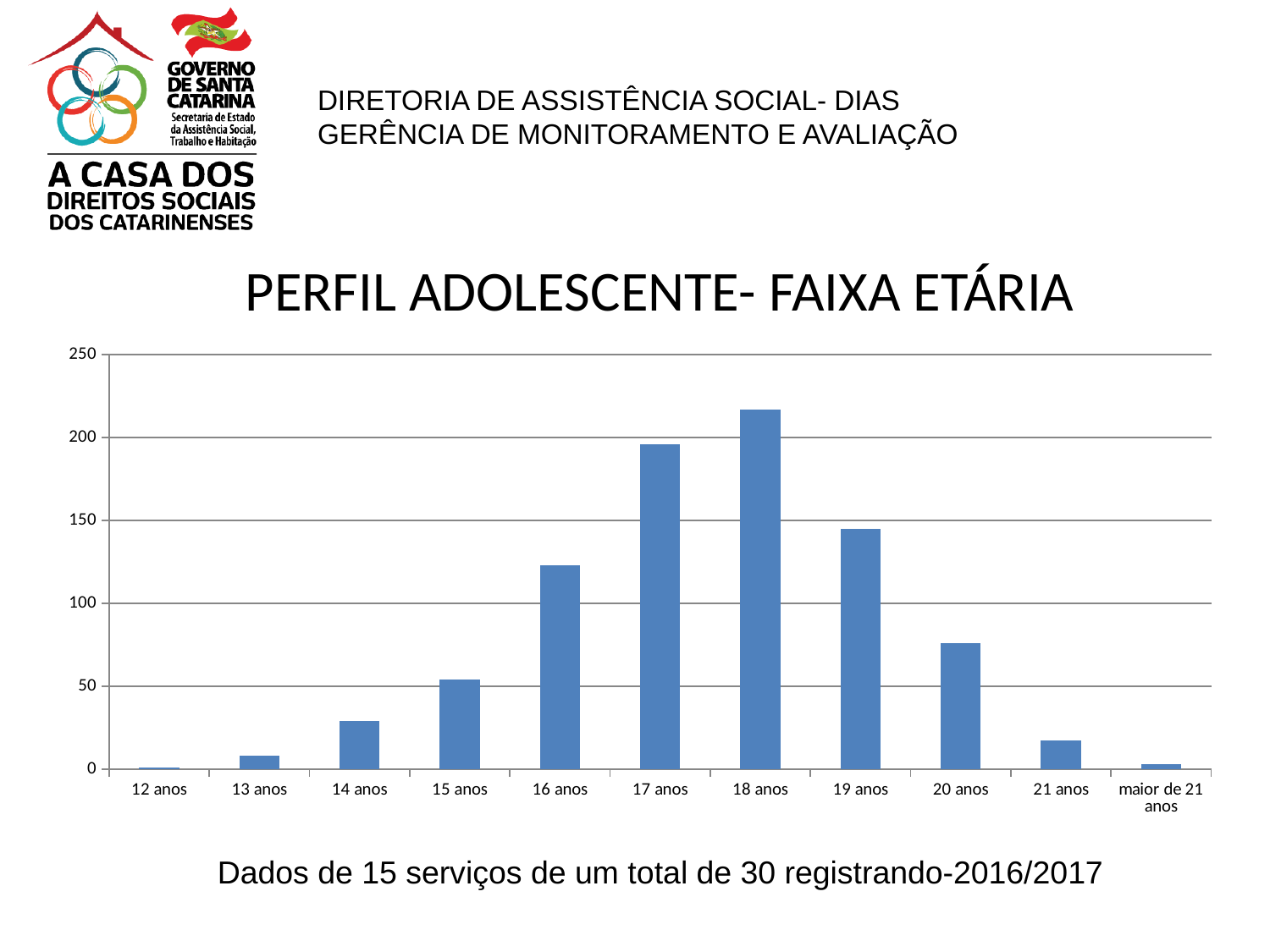
Do the values rise or fall from 12 anos to 18 anos along the x axis? rise Which age category has the highest value? 18 anos Is the value for 16 anos greater or less than 100? greater What type of chart is shown on the slide? Bar chart Which is larger, the value for 17 anos or the value for 19 anos? 17 anos Is the value for 21 anos greater or less than 50? less Is the value for 17 anos greater or less than 150? greater How many age categories are shown on the x axis? 11 What is the title of the chart? PERFIL ADOLESCENTE- FAIXA ETÁRIA Which is larger, the value for 16 anos or the value for 20 anos? 16 anos